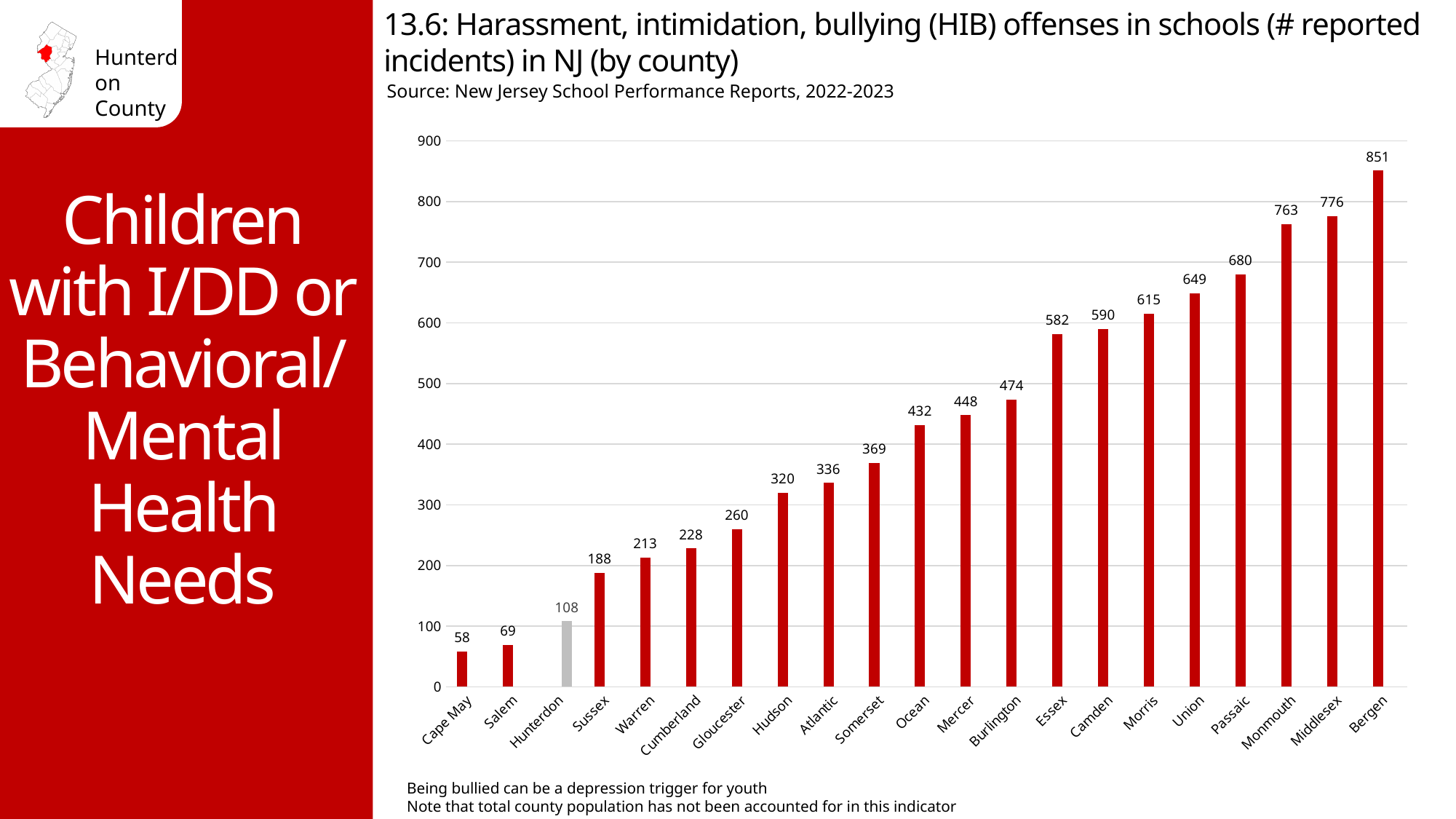
Which county has the highest number of reported HIB incidents? Bergen Which county has more reported HIB incidents, Essex or Camden? Camden What is the number of reported HIB incidents for Hunterdon? 108 How many counties are shown on the chart? 21 Which county has the lowest number of reported HIB incidents? Cape May What is the difference in reported HIB incidents between Bergen and Cape May? 793 What is the difference in reported HIB incidents between Hunterdon and Sussex? 80 What is the number of reported HIB incidents for Monmouth? 763 Which county's bar is shown in grey rather than red? Hunterdon Do the values rise or fall from left to right along the x axis? rise Is the value for Ocean greater or less than 400? greater What kind of chart is shown on the slide? bar chart